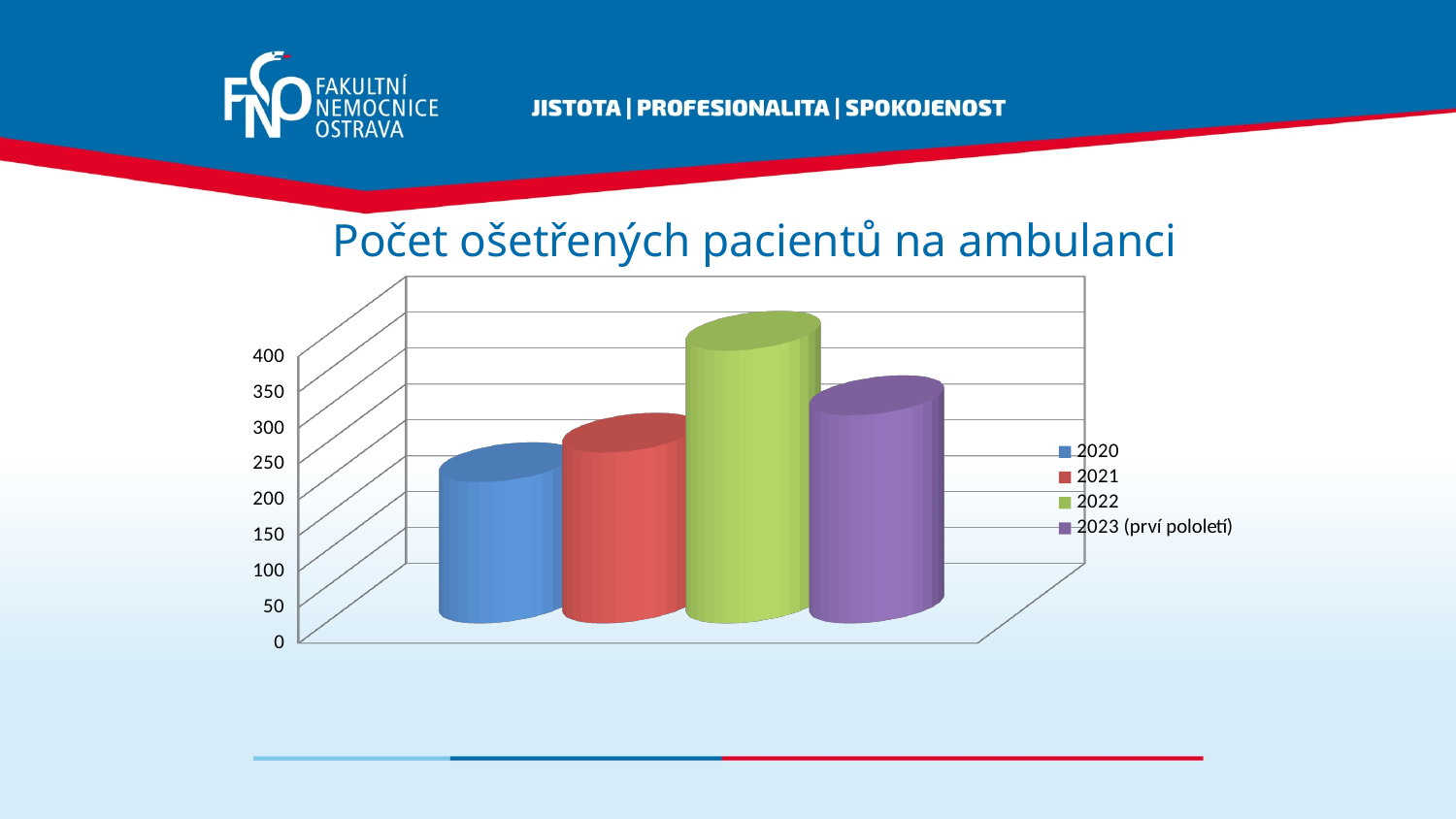
What kind of chart is shown on the slide? bar chart What is the title of the chart? Počet ošetřených pacientů na ambulanci Is the value for 2023 (prví pololetí) greater or less than 200? greater How many series does the legend list? 4 Which is larger, the value for 2021 or the value for 2020? 2021 Do the values rise or fall from 2020 to 2022? rise Is the value for 2021 greater or less than 350? less Is the value for 2022 greater or less than 300? greater Which series has the lowest value? 2020 Which is larger, the value for 2022 or the value for 2023 (prví pololetí)? 2022 Which series has the highest value? 2022